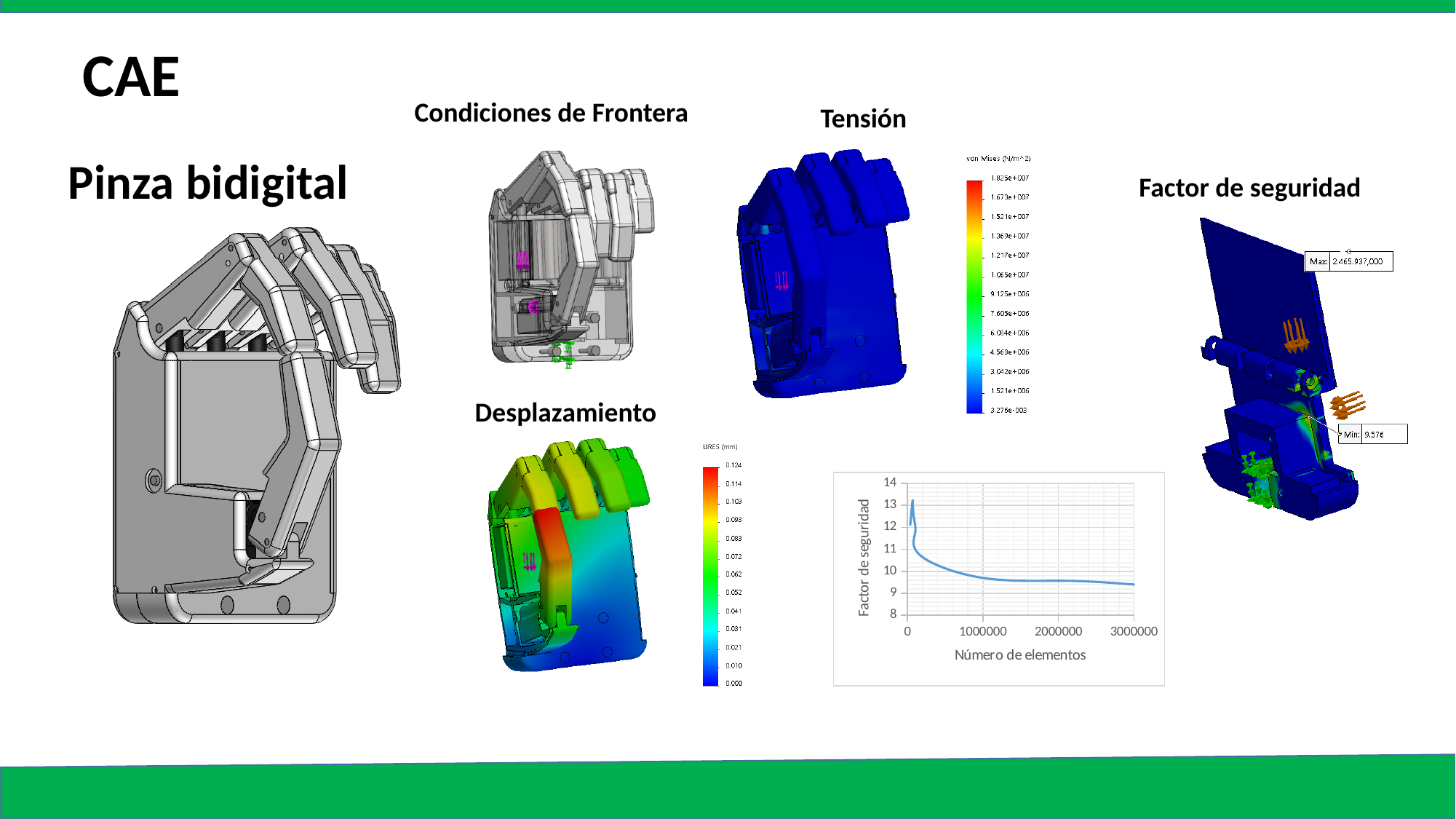
What is the lowest tick value shown on the y axis of the line chart? 8 What is the label of the x axis of the line chart? Número de elementos In the line chart, is the factor de seguridad at 1000000 elements greater or less than 11? less In the line chart, does the factor de seguridad rise or fall as the número de elementos increases? fall In the line chart, is the factor de seguridad at 3000000 elements greater or less than 10? less In the line chart, is the factor de seguridad higher at 0 elements or at 2000000 elements? 0 elements In the line chart, is the factor de seguridad at 3000000 elements greater or less than 9? greater What is the largest tick value shown on the x axis of the line chart? 3000000 What is the label of the y axis of the line chart? Factor de seguridad What kind of chart is the chart with the x axis labelled 'Número de elementos'? line chart